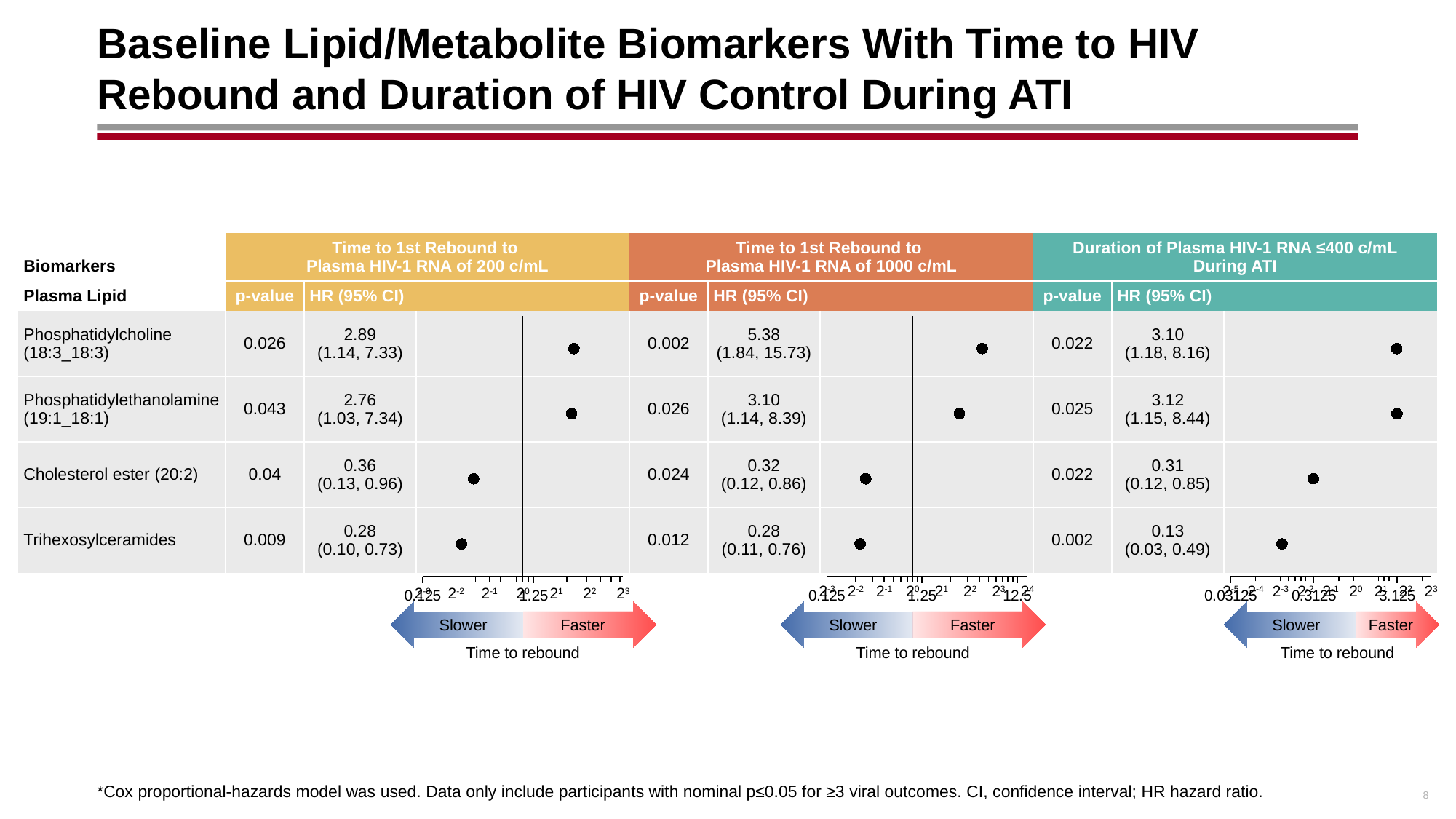
What kind of chart is used to display the hazard ratios on this slide? Forest plot (dot plot) In the 'Duration of Plasma HIV-1 RNA ≤400 c/mL During ATI' panel, what is the p-value for Trihexosylceramides? 0.002 In the 'Time to 1st Rebound to Plasma HIV-1 RNA of 200 c/mL' panel, is the HR point for Cholesterol ester (20:2) greater or less than 1 (2^0)? less In the 'Duration of Plasma HIV-1 RNA ≤400 c/mL During ATI' panel, what is the HR for Cholesterol ester (20:2)? 0.31 How many biomarkers are plotted in each forest plot panel? 4 In the 'Time to 1st Rebound to Plasma HIV-1 RNA of 1000 c/mL' panel, what is the difference between the HR for Phosphatidylcholine (18:3_18:3) and the HR for Phosphatidylethanolamine (19:1_18:1)? 2.28 In the 'Duration of Plasma HIV-1 RNA ≤400 c/mL During ATI' panel, which biomarker has the lowest hazard ratio? Trihexosylceramides In the 'Time to 1st Rebound to Plasma HIV-1 RNA of 1000 c/mL' panel, what is the p-value for Trihexosylceramides? 0.012 In the 'Time to 1st Rebound to Plasma HIV-1 RNA of 1000 c/mL' panel, which biomarker has the highest hazard ratio? Phosphatidylcholine (18:3_18:3) In the 'Time to 1st Rebound to Plasma HIV-1 RNA of 200 c/mL' panel, which has the larger HR: Phosphatidylcholine (18:3_18:3) or Phosphatidylethanolamine (19:1_18:1)? Phosphatidylcholine (18:3_18:3) What label appears under the arrow beneath each forest plot panel? Time to rebound In the 'Time to 1st Rebound to Plasma HIV-1 RNA of 200 c/mL' panel, what is the HR (95% CI) for Phosphatidylcholine (18:3_18:3)? 2.89 (1.14, 7.33)